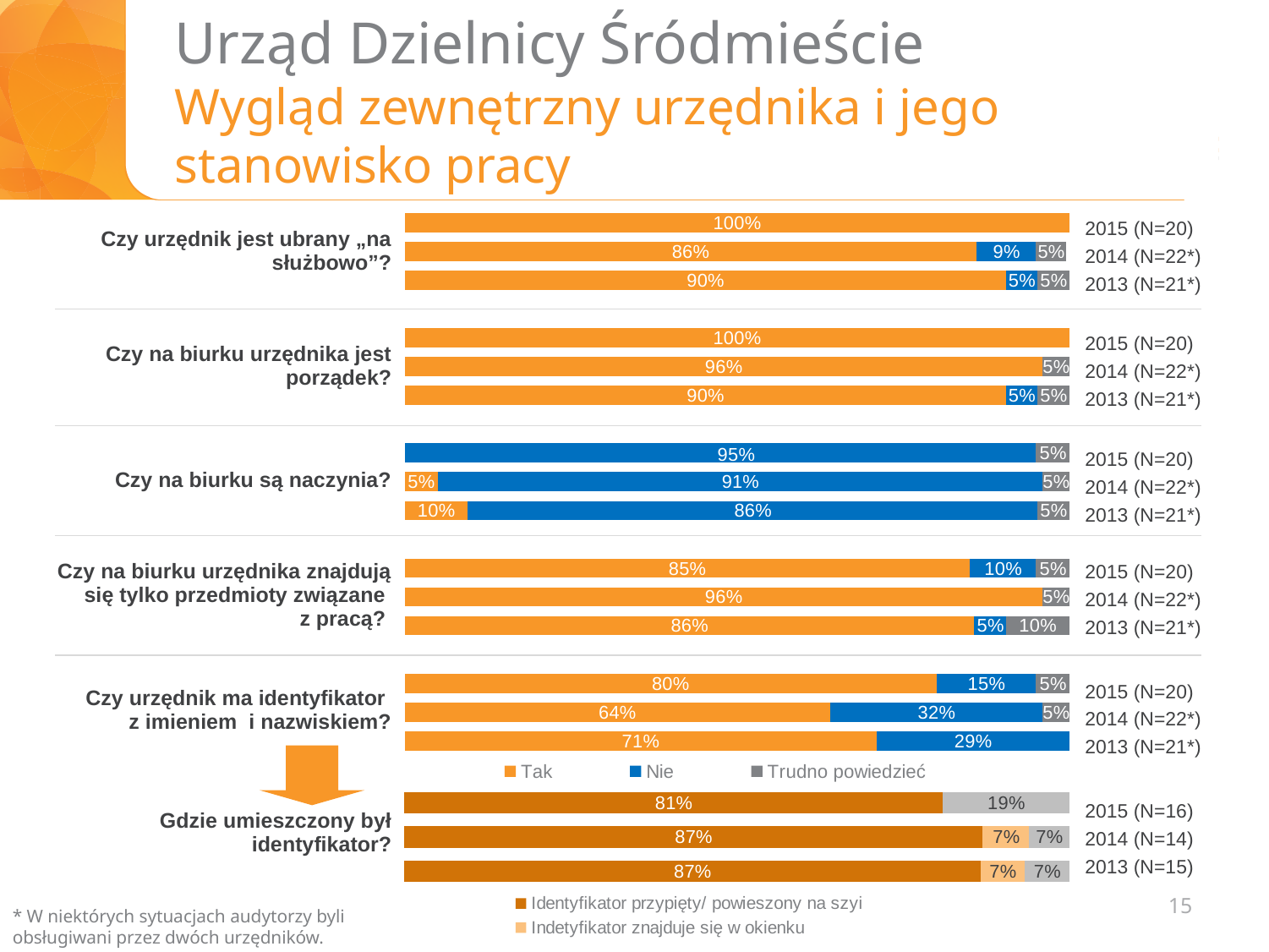
In the chart for "Czy urzędnik ma identyfikator z imieniem i nazwiskiem?", what is the difference between the "Tak" values for 2015 (N=20) and 2013 (N=21*)? 9% In the chart for "Czy na biurku urzędnika znajdują się tylko przedmioty związane z pracą?", is the "Tak" value for 2014 (N=22*) larger or smaller than for 2015 (N=20)? larger How many series does the legend list for the "Czy urzędnik ma identyfikator z imieniem i nazwiskiem?" chart? 3 In the chart for "Czy na biurku urzędnika jest porządek?", what is the "Tak" value for 2014 (N=22*)? 96% In the chart for "Czy urzędnik jest ubrany „na służbowo”?", what is the "Nie" value for 2014 (N=22*)? 9% In the chart for "Czy urzędnik ma identyfikator z imieniem i nazwiskiem?", which year has the lowest "Tak" value? 2014 (N=22*) In the chart for "Gdzie umieszczony był identyfikator?", what is the value for "Identyfikator przypięty/ powieszony na szyi" in 2015 (N=16)? 81% In the chart for "Czy na biurku są naczynia?", what is the "Nie" value for 2013 (N=21*)? 86% In the chart for "Czy urzędnik jest ubrany „na służbowo”?", what is the "Tak" value for 2015 (N=20)? 100% In the chart for "Czy na biurku są naczynia?", which year has the highest "Nie" value? 2015 (N=20) In the chart for "Czy urzędnik ma identyfikator z imieniem i nazwiskiem?", what is the "Nie" value for 2014 (N=22*)? 32% What type of chart is used for "Gdzie umieszczony był identyfikator?"? Stacked bar chart